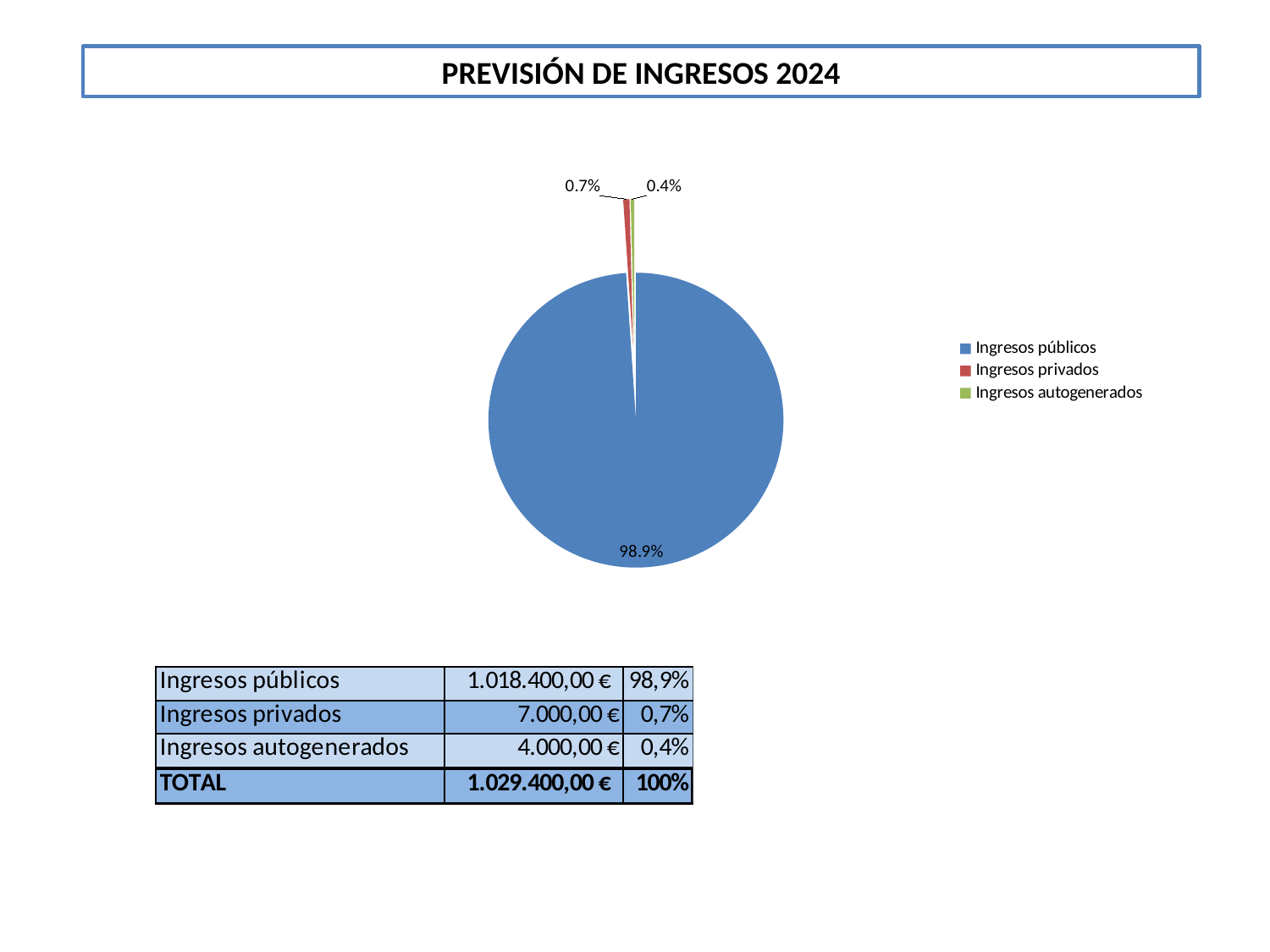
Which category has the smallest slice of the pie? Ingresos autogenerados What colour is the Ingresos públicos slice in the pie chart? blue What share of the pie does Ingresos públicos represent? 98.9% What kind of chart is shown on the slide? pie chart What share of the pie does Ingresos privados represent? 0.7% How many entries does the legend list? 3 What is the title shown above the chart? PREVISIÓN DE INGRESOS 2024 How many slices does the pie chart have? 3 Which slice is larger, Ingresos privados or Ingresos autogenerados? Ingresos privados What is the difference in percentage points between the Ingresos privados slice and the Ingresos autogenerados slice? 0.3% What share of the pie does Ingresos autogenerados represent? 0.4% Which category has the largest slice of the pie? Ingresos públicos